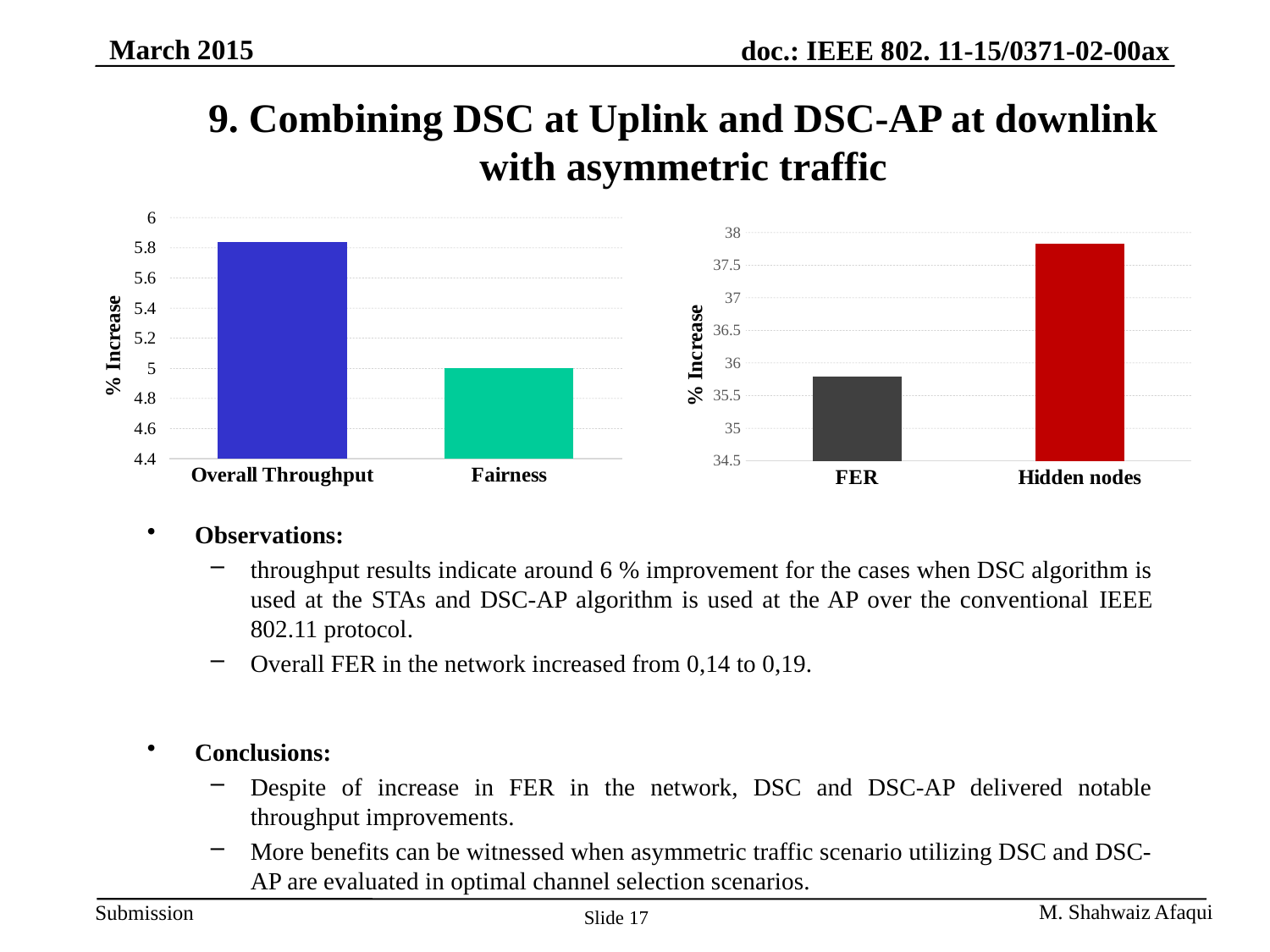
What is the y-axis label on the right chart? % Increase On the left chart, which category has the higher value, Overall Throughput or Fairness? Overall Throughput On the left chart, how many categories are plotted? 2 On the left chart, is the value for Fairness greater or less than 5.4? less On the left chart, is the value for Overall Throughput greater or less than 5.6? greater On the right chart, is the value for FER greater or less than 36? less On the right chart, which category has the highest value? Hidden nodes What type of chart is the left chart? bar chart On the right chart, what colour is the Hidden nodes bar? red On the right chart, how many categories are plotted? 2 On the right chart, which category has the lowest value? FER